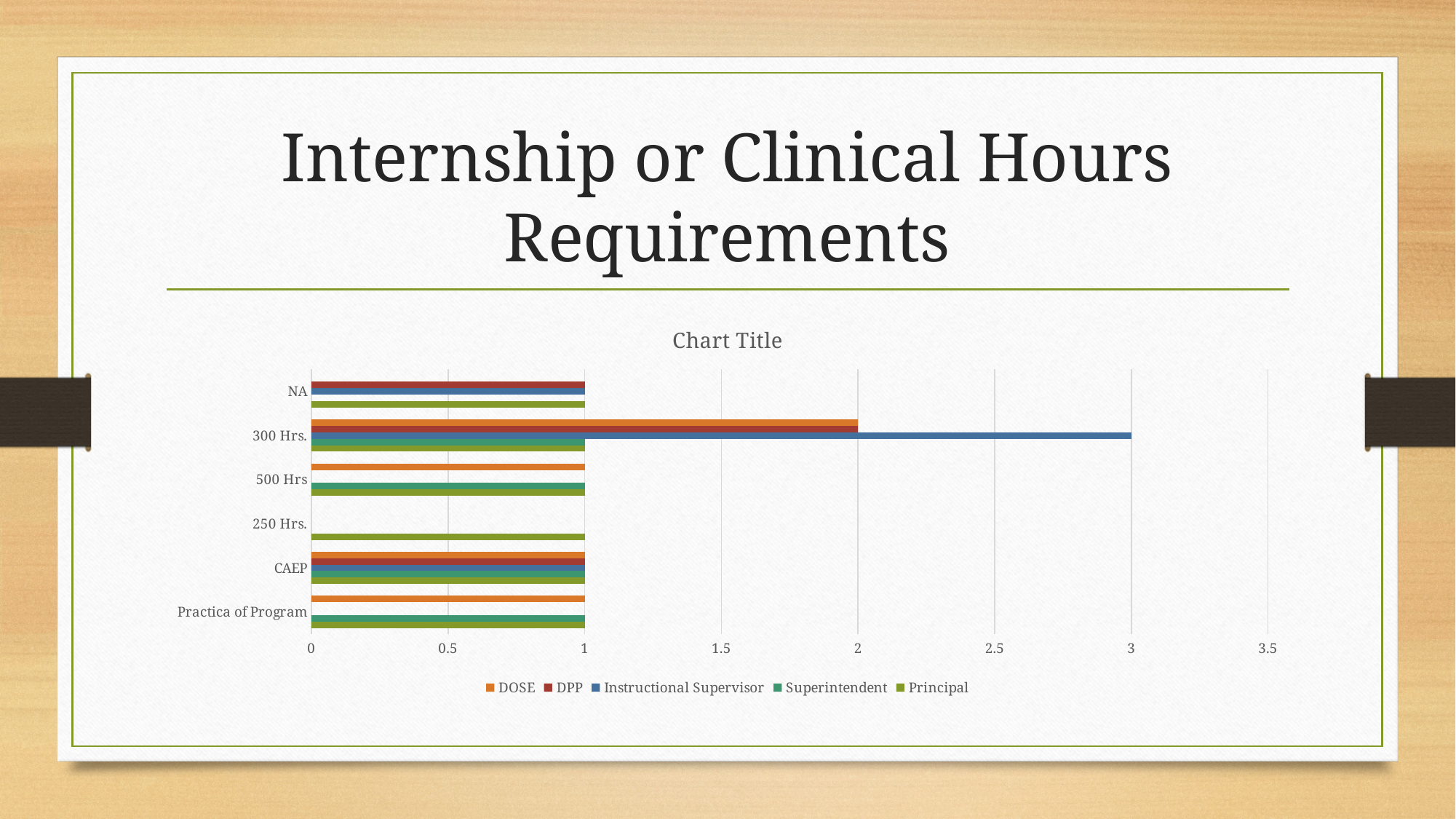
Is the value for Instructional Supervisor in the 300 Hrs. category greater or less than 2.5? greater What is the value for DOSE in the 300 Hrs. category? 2 What kind of chart is shown on the slide? bar chart Which series is listed first in the chart legend? DOSE How many series does the chart legend list? 5 How many categories are listed on the vertical axis of the chart? 6 What is the value for Instructional Supervisor in the 300 Hrs. category? 3 What is the title shown above the chart? Chart Title What is the difference between the Instructional Supervisor value and the DOSE value in the 300 Hrs. category? 1 In which category does the Instructional Supervisor series reach its highest value? 300 Hrs. What is the value for Principal in the 250 Hrs. category? 1